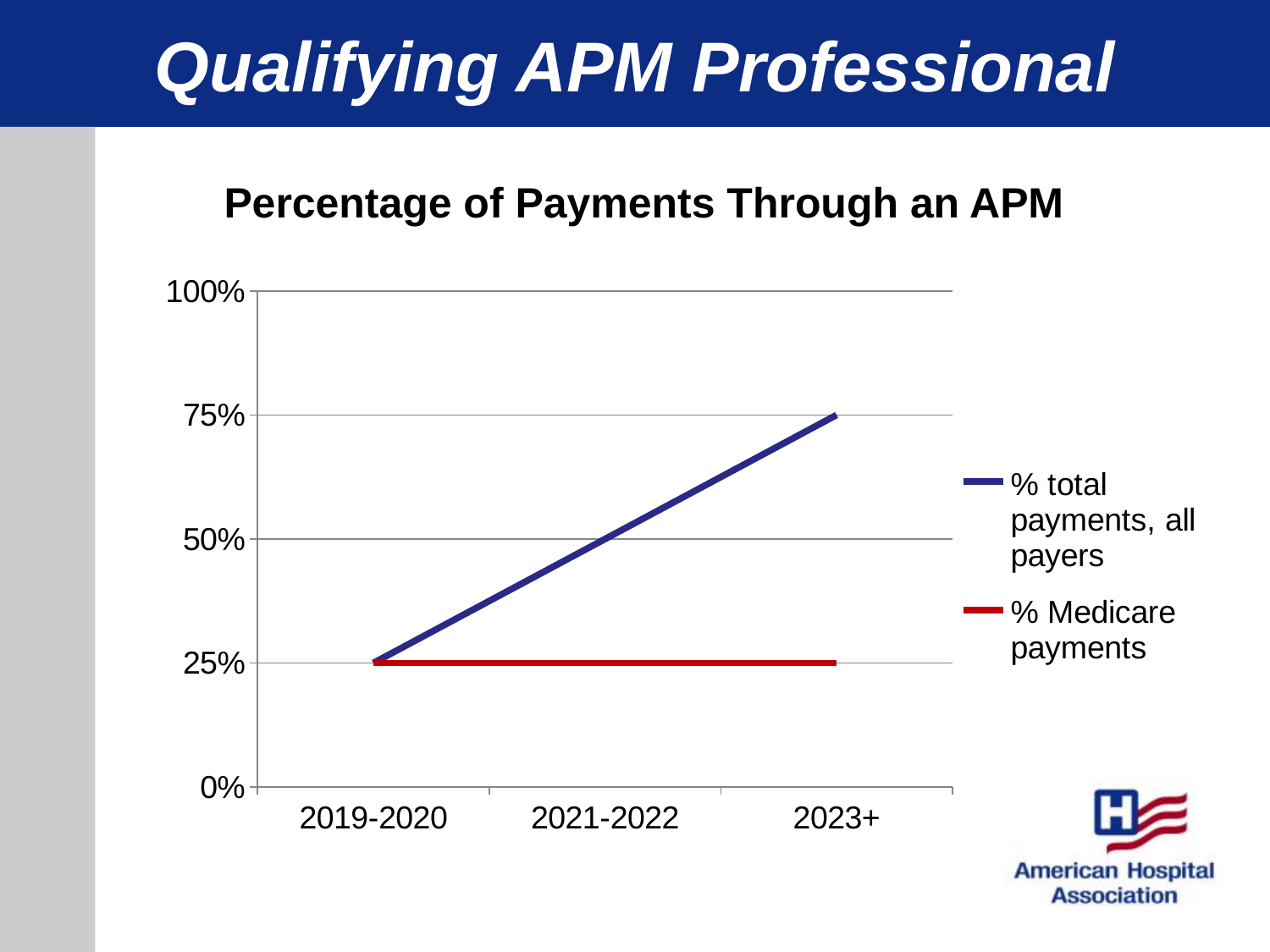
Which colour is used for the % Medicare payments line? Red What is the value of % total payments, all payers for 2023+? 75% What is the value of % Medicare payments for 2023+? 25% Does the % Medicare payments line rise, fall, or stay flat across the periods? Stay flat Which series is higher in 2023+, % total payments, all payers or % Medicare payments? % total payments, all payers What is the difference between % total payments, all payers and % Medicare payments in 2023+? 50% Does the % total payments, all payers line rise or fall from 2019-2020 to 2023+? Rise What kind of chart is shown on the slide? Line chart How many series does the legend list? 2 How many periods are shown on the x axis? 3 What is the title of the chart? Percentage of Payments Through an APM What is the value of % total payments, all payers for 2019-2020? 25%